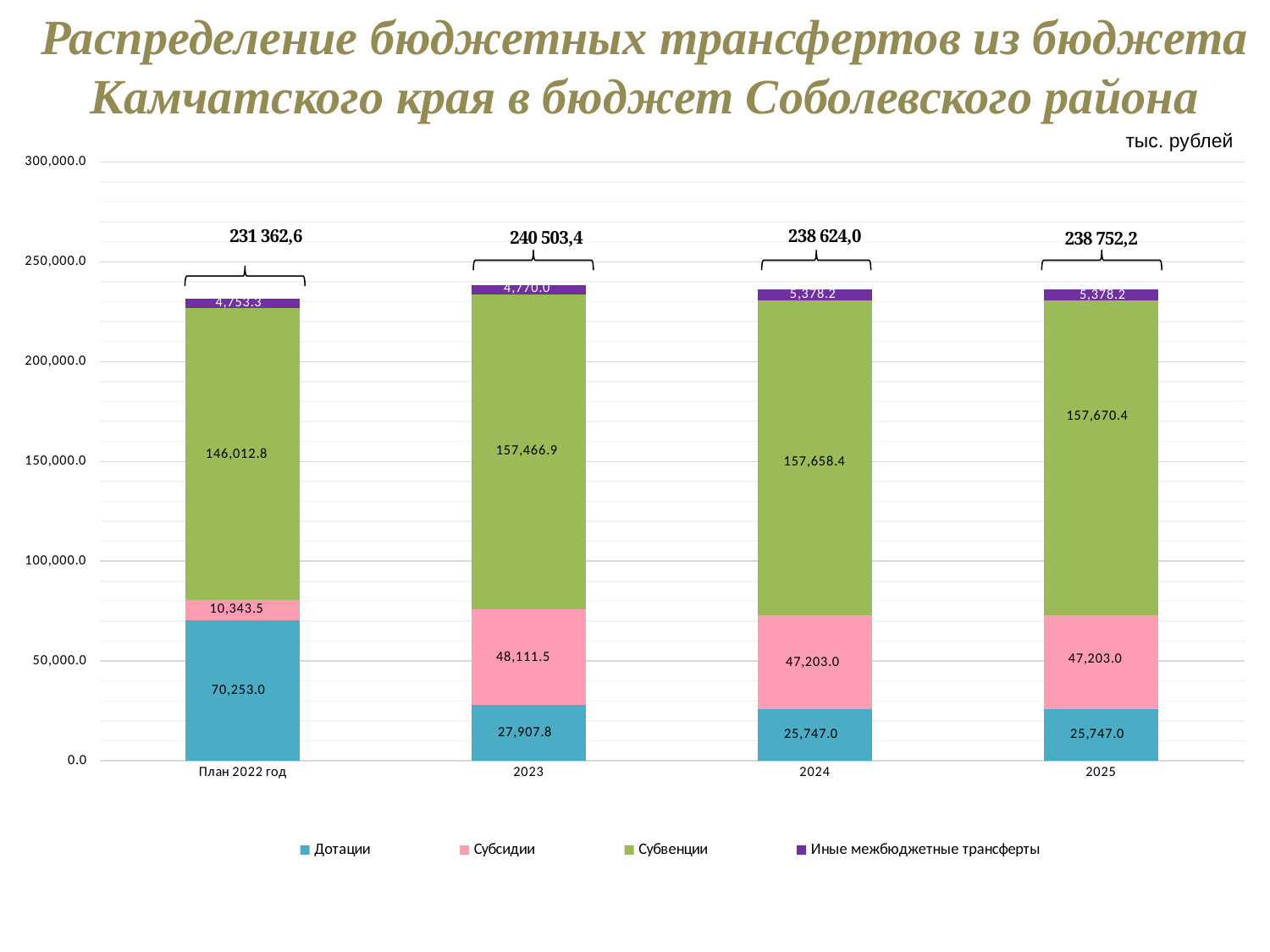
What is the value of Иные межбюджетные трансферты for 2025? 5,378.2 What type of chart is shown on the slide? stacked bar chart How many categories are shown on the x axis? 4 What is the value of Субвенции for 2024? 157,658.4 What is the value of Субсидии for 2023? 48,111.5 What is the total printed above the bar for 2023? 240 503,4 What is the value of Дотации for План 2022 год? 70,253.0 How many series does the legend list? 4 Which category has the highest value for Дотации? План 2022 год Is the Субвенции value for 2025 larger or smaller than the Субвенции value for План 2022 год? larger Which category has the lowest value for Субсидии? План 2022 год What is the difference between the Дотации values for План 2022 год and 2023? 42,345.2